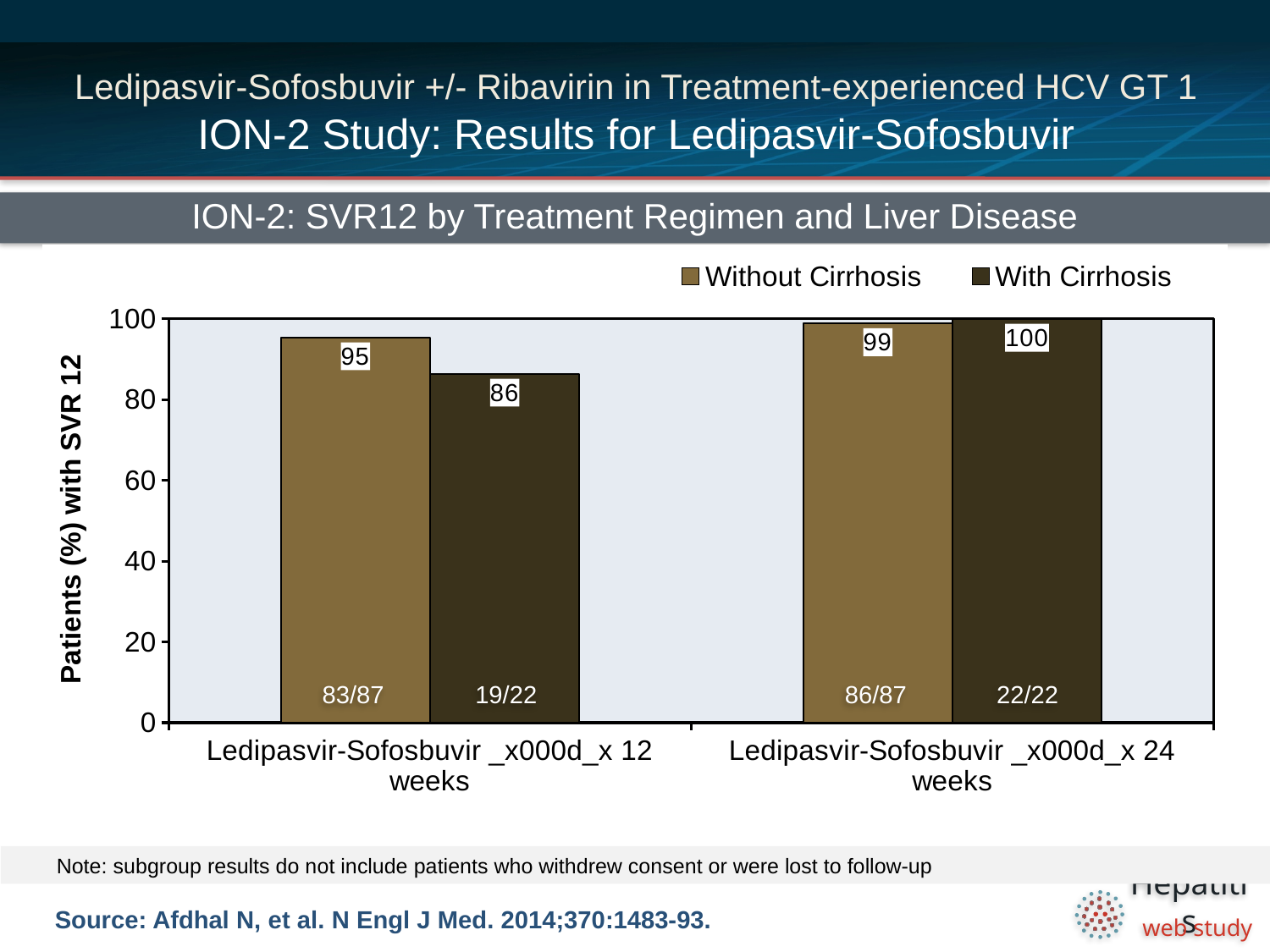
What is the SVR12 rate for patients with cirrhosis treated with Ledipasvir-Sofosbuvir for 12 weeks? 86 In the 12-week arm, which group has the higher SVR12 rate: without cirrhosis or with cirrhosis? Without Cirrhosis What is the SVR12 rate for patients without cirrhosis treated with Ledipasvir-Sofosbuvir for 12 weeks? 95 Which group has the highest SVR12 rate on the chart? With Cirrhosis, Ledipasvir-Sofosbuvir x 24 weeks How many treatment regimen categories are shown on the x axis? 2 What is the SVR12 rate for patients with cirrhosis treated with Ledipasvir-Sofosbuvir for 24 weeks? 100 What is the difference in SVR12 rate between patients without cirrhosis and with cirrhosis in the 12-week arm? 9 What is the SVR12 rate for patients without cirrhosis treated with Ledipasvir-Sofosbuvir for 24 weeks? 99 What is the label of the y axis? Patients (%) with SVR 12 Which group has the lowest SVR12 rate on the chart? With Cirrhosis, Ledipasvir-Sofosbuvir x 12 weeks What kind of chart is shown on the slide? Bar chart How many series does the legend list? 2